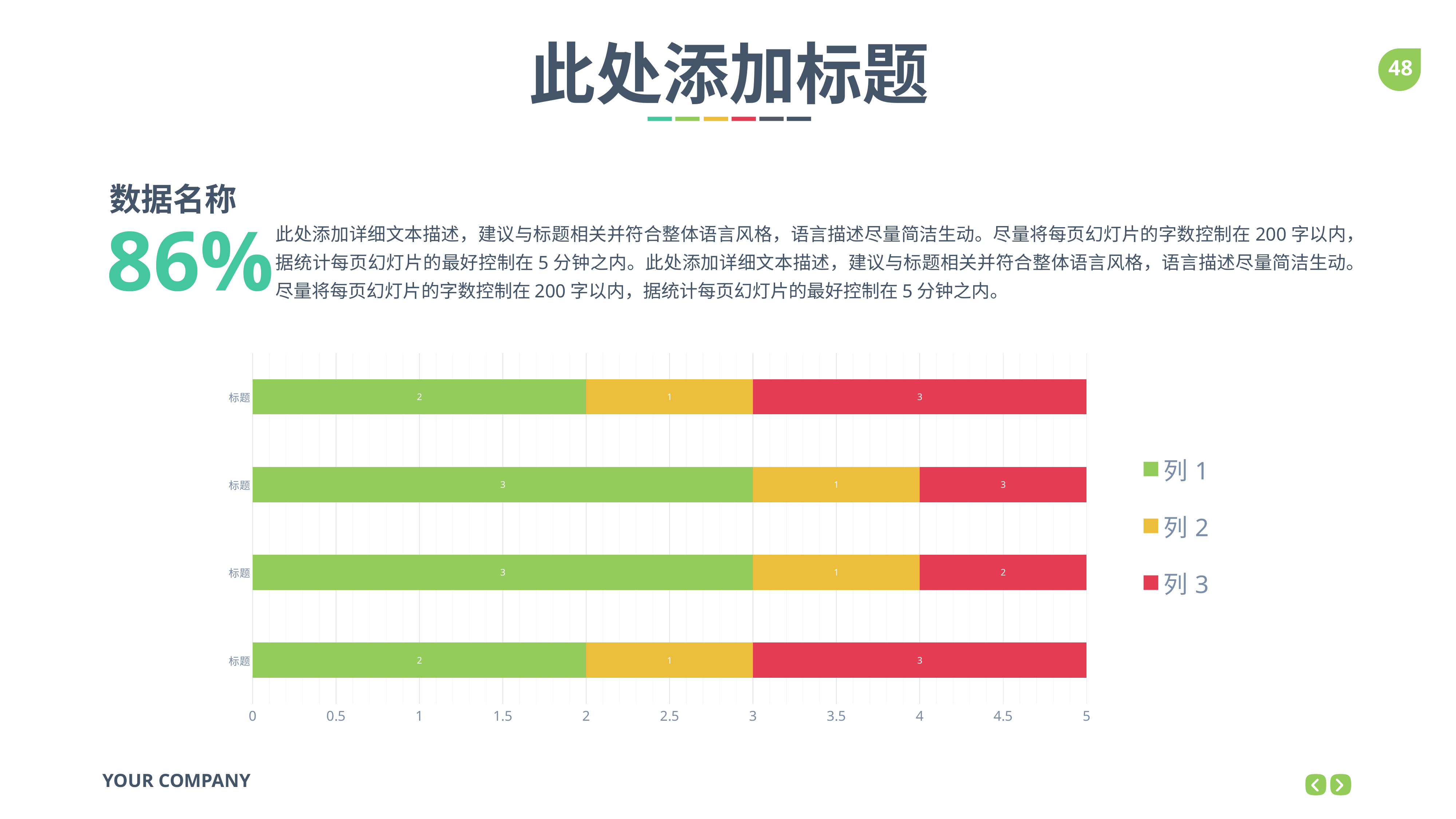
How many bars (categories) are plotted in the chart? 4 What is the data label for 列 3 in the third bar from the top? 2 What kind of chart is shown on the slide? Stacked bar chart What is the data label for 列 3 in the bottom bar? 3 What is the data label for 列 2 in the bottom bar? 1 What is the difference between the 列 3 label in the second bar from the top and the 列 3 label in the third bar from the top? 1 What is the data label for 列 1 in the second bar from the top? 3 How many series does the chart legend list? 3 What are the three series names listed in the chart legend? 列 1, 列 2, 列 3 What is the data label for 列 1 in the topmost bar? 2 Which is larger: the 列 1 label in the top bar or the 列 1 label in the second bar from the top? The second bar from the top Which colour represents 列 3 in the chart? Red